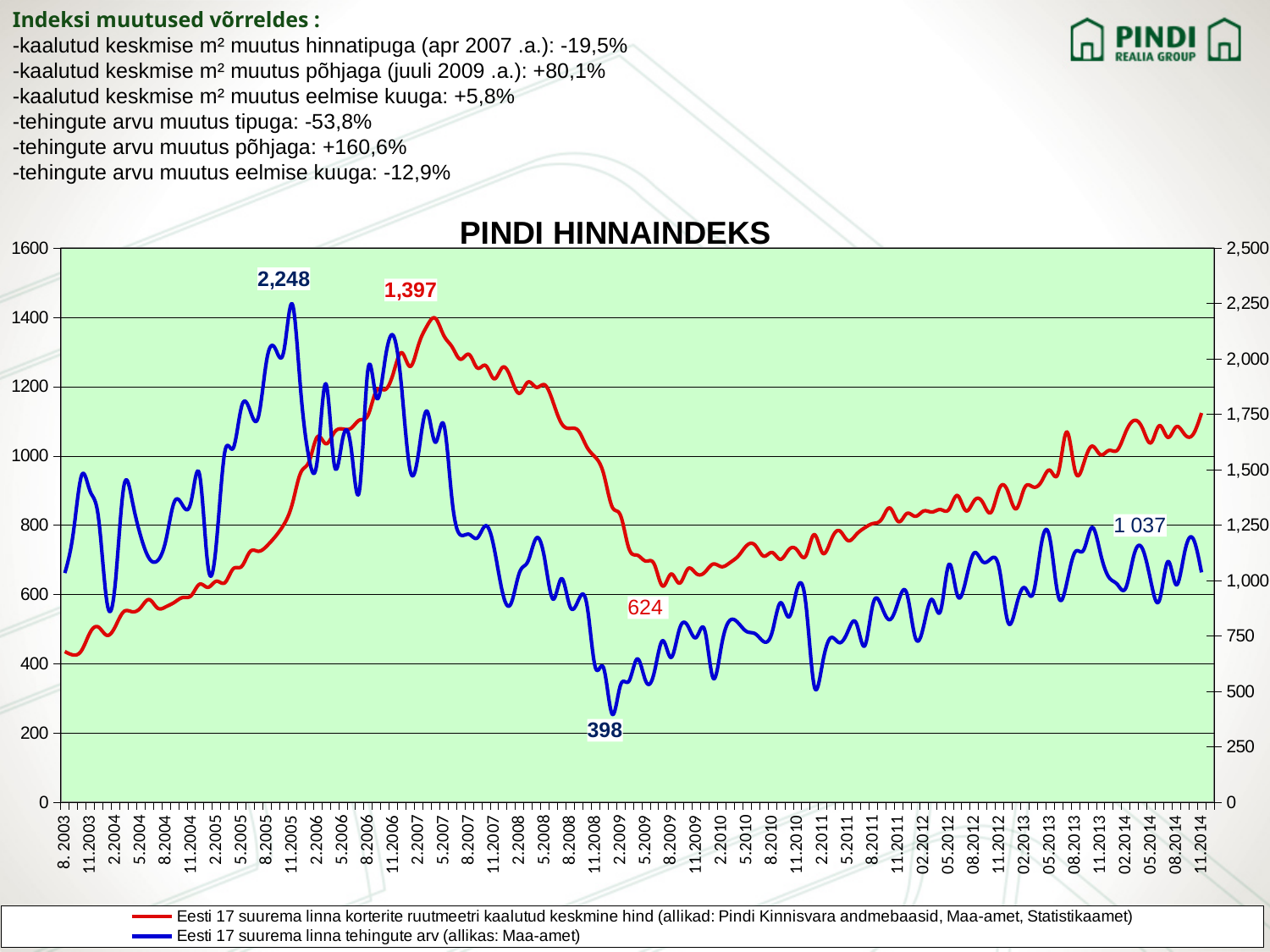
How many series does the legend of the PINDI HINNAINDEKS chart list? 2 What is the title of the chart? PINDI HINNAINDEKS What is the peak value labelled on the blue line (number of transactions)? 2,248 What is the difference between the labelled peak (1,397) and the labelled trough (624) of the red line? 773 Does the red line (weighted average price) rise or fall from 8.2009 to 11.2014? rise What is the lowest value labelled on the red line (weighted average price per square metre)? 624 What is the value labelled at the end of the blue line (number of transactions) in 2014? 1 037 Is the value of the red line at 11.2014 greater or less than 1000 on the left axis? greater What kind of chart is shown on the slide? line chart What is the lowest value labelled on the blue line (number of transactions)? 398 What is the difference between the labelled peak (2,248) and the labelled trough (398) of the blue line? 1,850 What is the peak value labelled on the red line (weighted average price per square metre)? 1,397